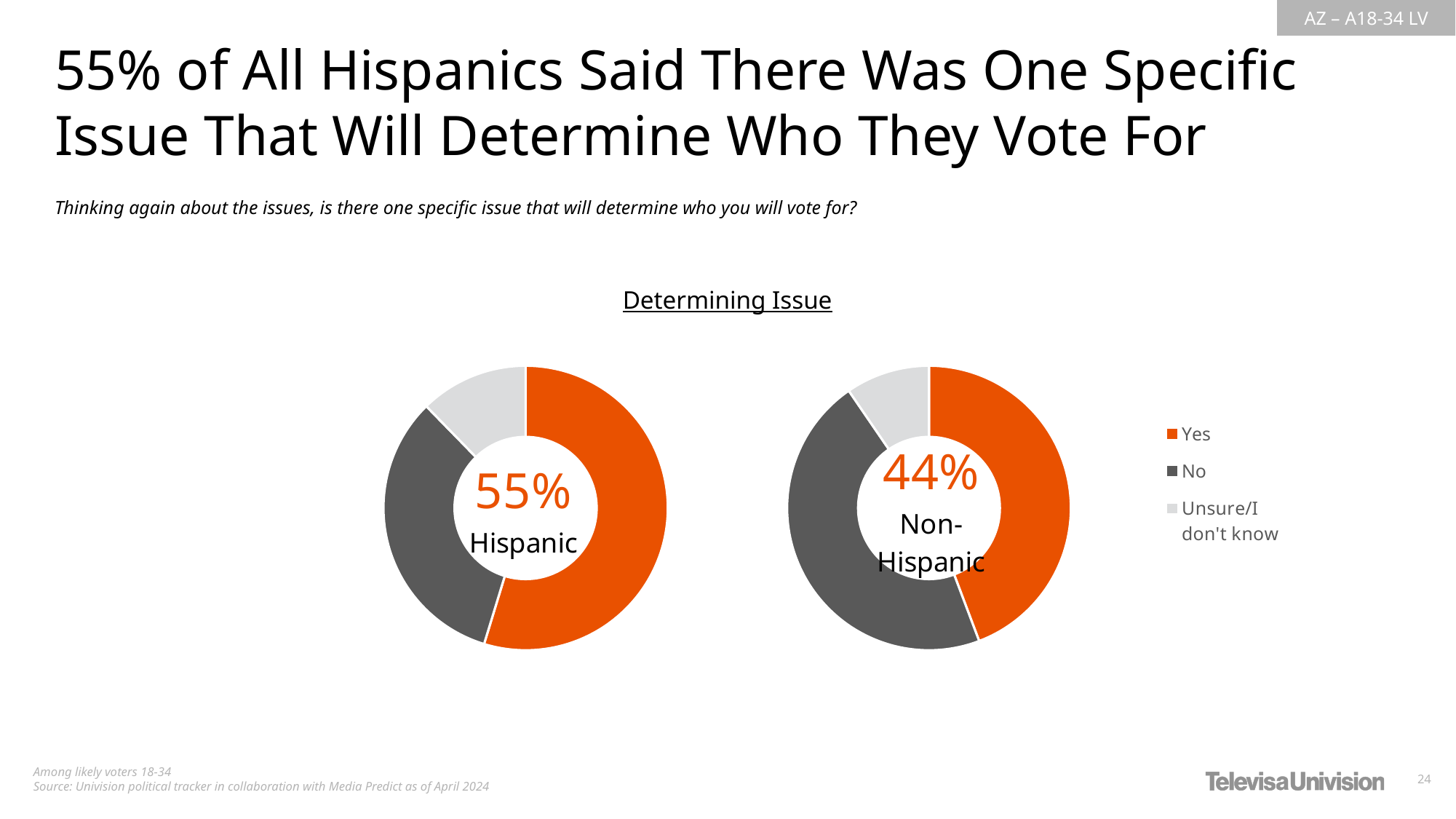
What is the difference in percentage points between the Hispanic Yes share and the Non-Hispanic Yes share? 11 percentage points In the Non-Hispanic donut chart, which response is the smallest slice? Unsure/I don't know What kind of chart is used to show the Determining Issue data? Donut (pie) chart In the Hispanic donut chart, what percentage said Yes? 55% What is the title shown above the two donut charts? Determining Issue In the Hispanic donut chart, which response is the largest slice? Yes In the Hispanic donut chart, which response is the smallest slice? Unsure/I don't know How many categories does the legend list for the Determining Issue charts? 3 In the Non-Hispanic donut chart, what percentage said Yes? 44% Is the Yes share in the Non-Hispanic donut chart greater or less than 50%? less Which group has the larger Yes share, Hispanic or Non-Hispanic? Hispanic What colour represents the Yes response in the donut charts? Orange